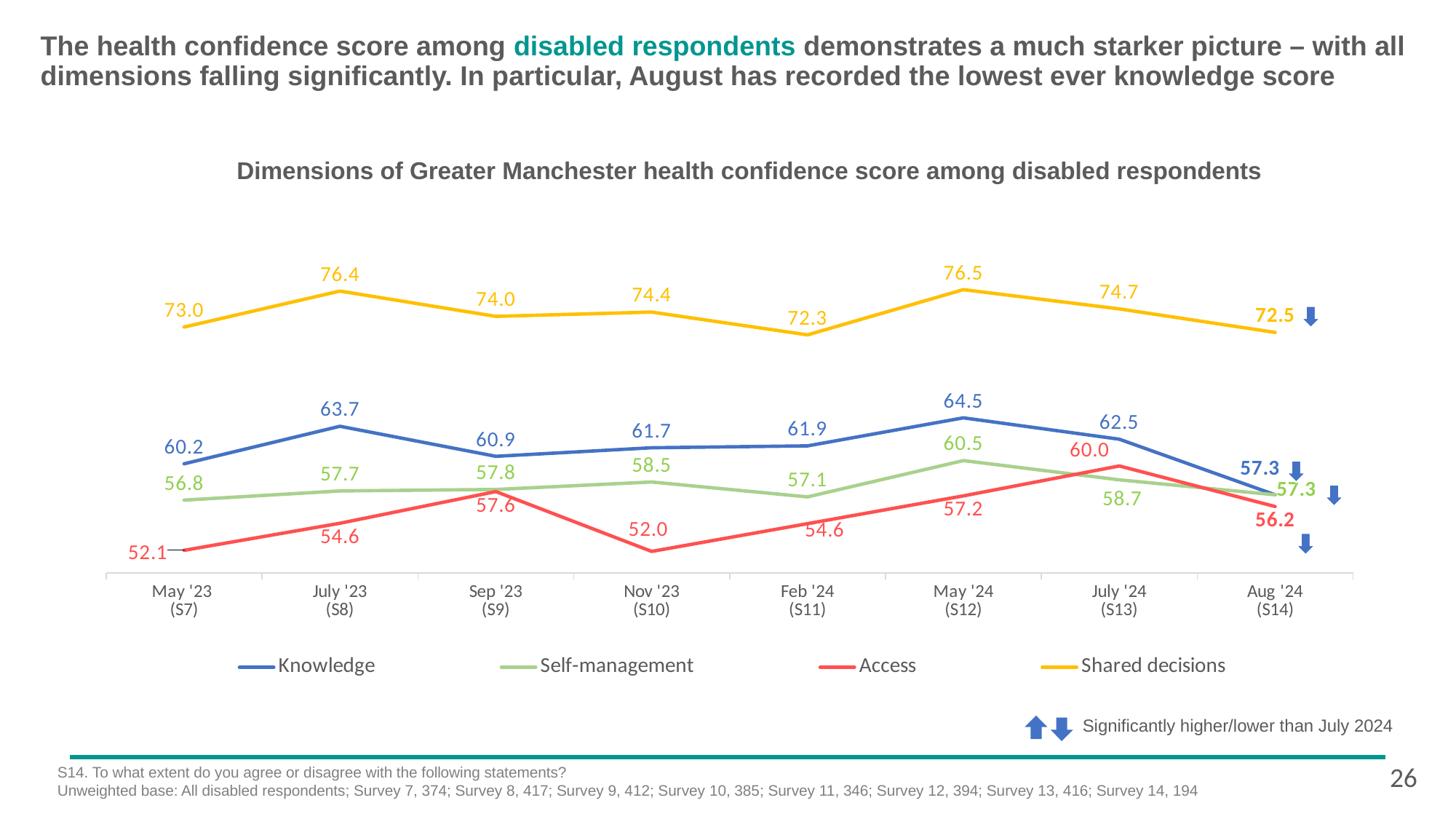
Which is larger in Sep '23 (S9): the Self-management score or the Access score? Self-management What is the Shared decisions score for May '24 (S12)? 76.5 What is the Self-management score for July '24 (S13)? 58.7 What is the Knowledge score for Aug '24 (S14)? 57.3 What is the difference between the Knowledge score in July '24 (S13) and Aug '24 (S14)? 5.2 In which survey period was the Knowledge score highest? May '24 (S12) Which colour represents the Shared decisions series? Yellow How many series does the legend list? 4 What is the Access score for Nov '23 (S10)? 52.0 How many survey periods are shown on the x axis? 8 In which survey period was the Access score lowest? Nov '23 (S10) What kind of chart is shown on the slide? Line chart